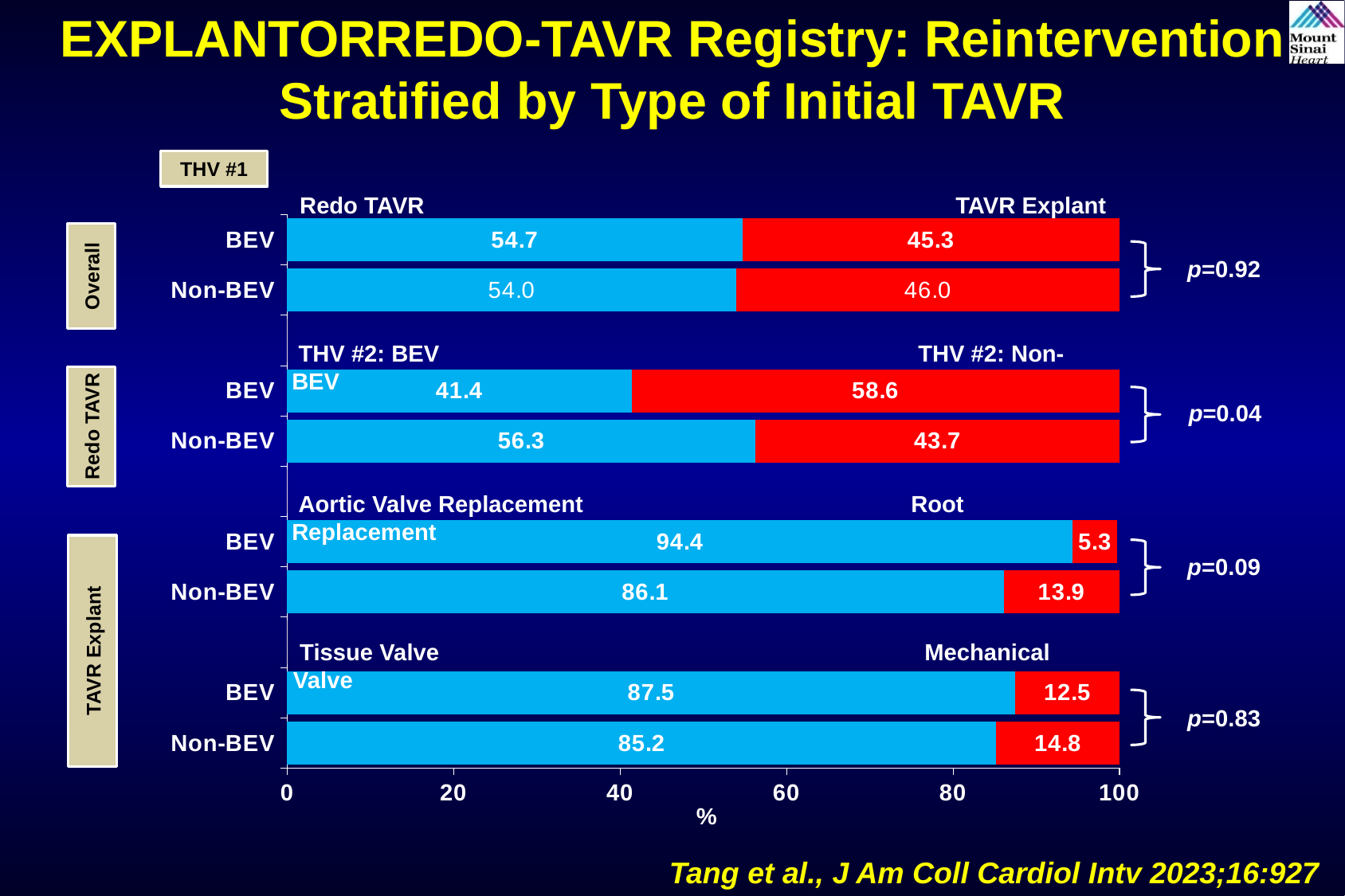
What type of chart is shown on the slide? Stacked bar chart Is the Tissue Valve percentage for Non-BEV patients in the TAVR Explant group greater or less than 80? greater What is the total of the BEV bar in the Overall group (54.7 + 45.3)? 100 In the Overall group, what percentage of Non-BEV patients underwent TAVR Explant? 46.0 In the TAVR Explant group, what percentage of Non-BEV patients had Root Replacement? 13.9 In the Redo TAVR group, what percentage of BEV patients received a Non-BEV THV #2? 58.6 What p-value is shown for the Redo TAVR comparison of THV #2 type between BEV and Non-BEV? p=0.04 In the Overall group, what percentage of BEV patients underwent Redo TAVR? 54.7 In the TAVR Explant group, what percentage of BEV patients received a Mechanical Valve? 12.5 What is the maximum value shown on the x axis of the chart? 100 In the Redo TAVR group, which initial valve type had the higher percentage receiving a BEV THV #2, BEV or Non-BEV? Non-BEV What is the difference between the Aortic Valve Replacement percentages for BEV (94.4) and Non-BEV (86.1) in the TAVR Explant group? 8.3